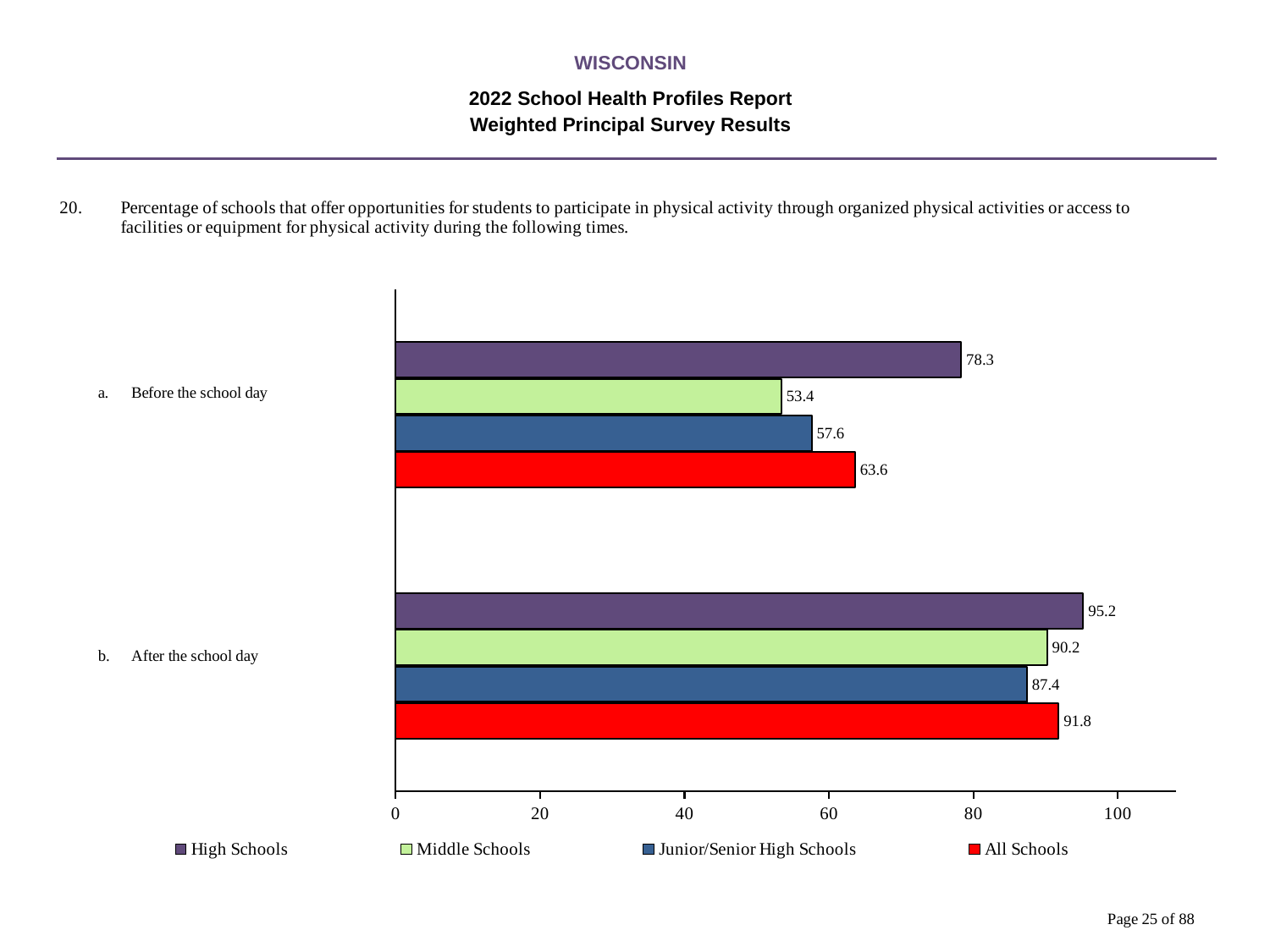
What kind of chart is shown on the slide? Bar chart Which is larger for 'Before the school day': the Junior/Senior High Schools value or the All Schools value? All Schools What colour are the bars for All Schools? Red How many series does the legend list? 4 What is the value for High Schools for 'Before the school day'? 78.3 How many categories (time periods) are shown on the chart? 2 What is the value for All Schools for 'Before the school day'? 63.6 What is the value for Junior/Senior High Schools for 'After the school day'? 87.4 Which school type has the lowest value for 'Before the school day'? Middle Schools What is the value for Middle Schools for 'After the school day'? 90.2 What is the difference between the High Schools values for 'After the school day' and 'Before the school day'? 16.9 Which school type has the highest value for 'After the school day'? High Schools